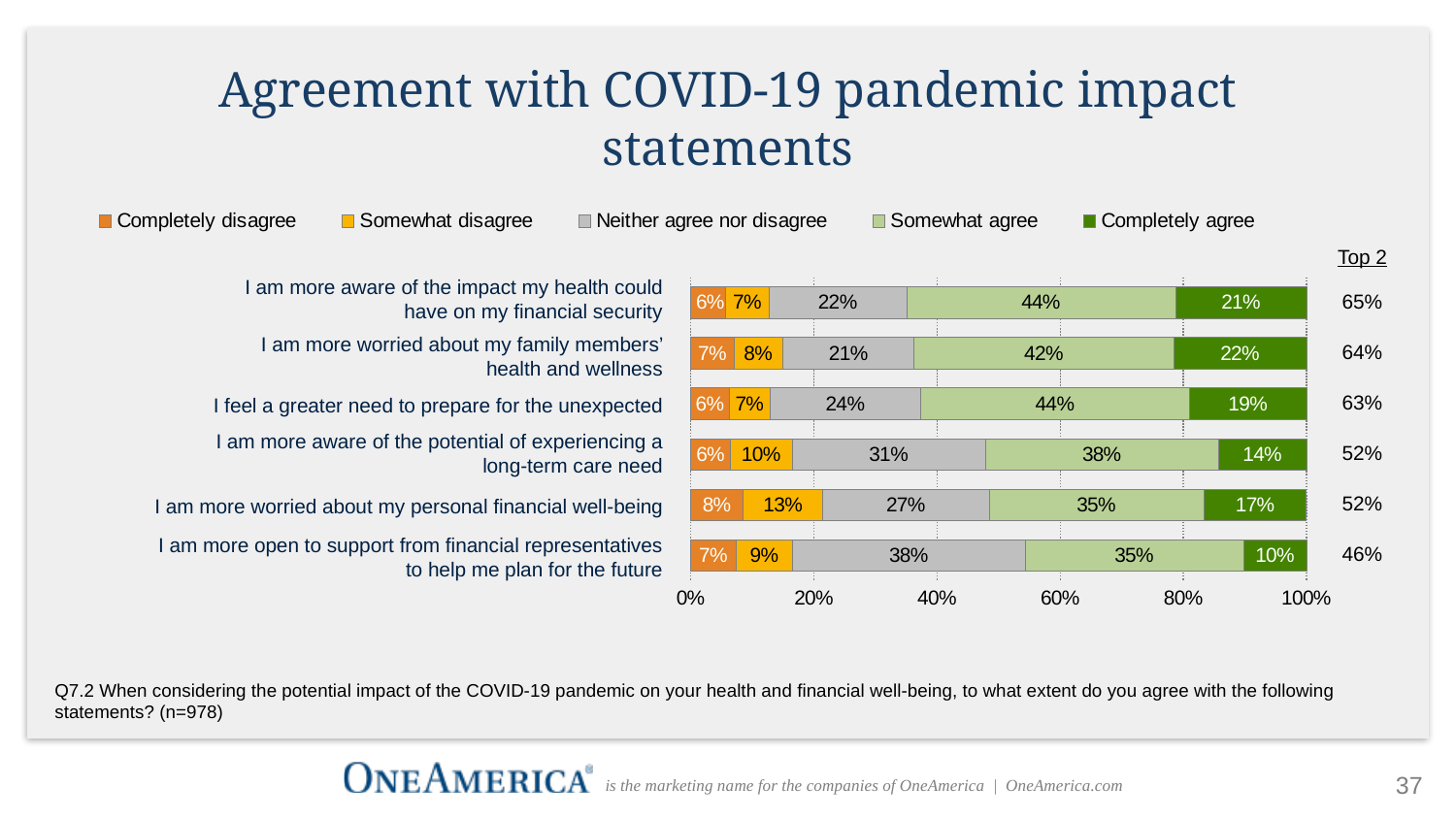
Which has a larger Somewhat disagree share: "I am more worried about my personal financial well-being" or "I am more aware of the potential of experiencing a long-term care need"? I am more worried about my personal financial well-being What percentage completely agree with the statement "I am more worried about my family members' health and wellness"? 22% For "I am more aware of the impact my health could have on my financial security", how much larger is the Somewhat agree share than the Completely agree share? 23 percentage points How many response categories does the legend list? 5 What colour represents Completely agree in the chart? Dark green What percentage neither agree nor disagree with "I am more open to support from financial representatives to help me plan for the future"? 38% What is the Completely disagree percentage for "I am more worried about my personal financial well-being"? 8% Which statement has the highest Completely agree percentage? I am more worried about my family members' health and wellness How many statements are shown in the chart? 6 Which statement has the lowest Completely agree percentage? I am more open to support from financial representatives to help me plan for the future What is the combined Somewhat agree and Completely agree (Top 2) share for "I feel a greater need to prepare for the unexpected"? 63% What kind of chart is shown on the slide? Stacked bar chart